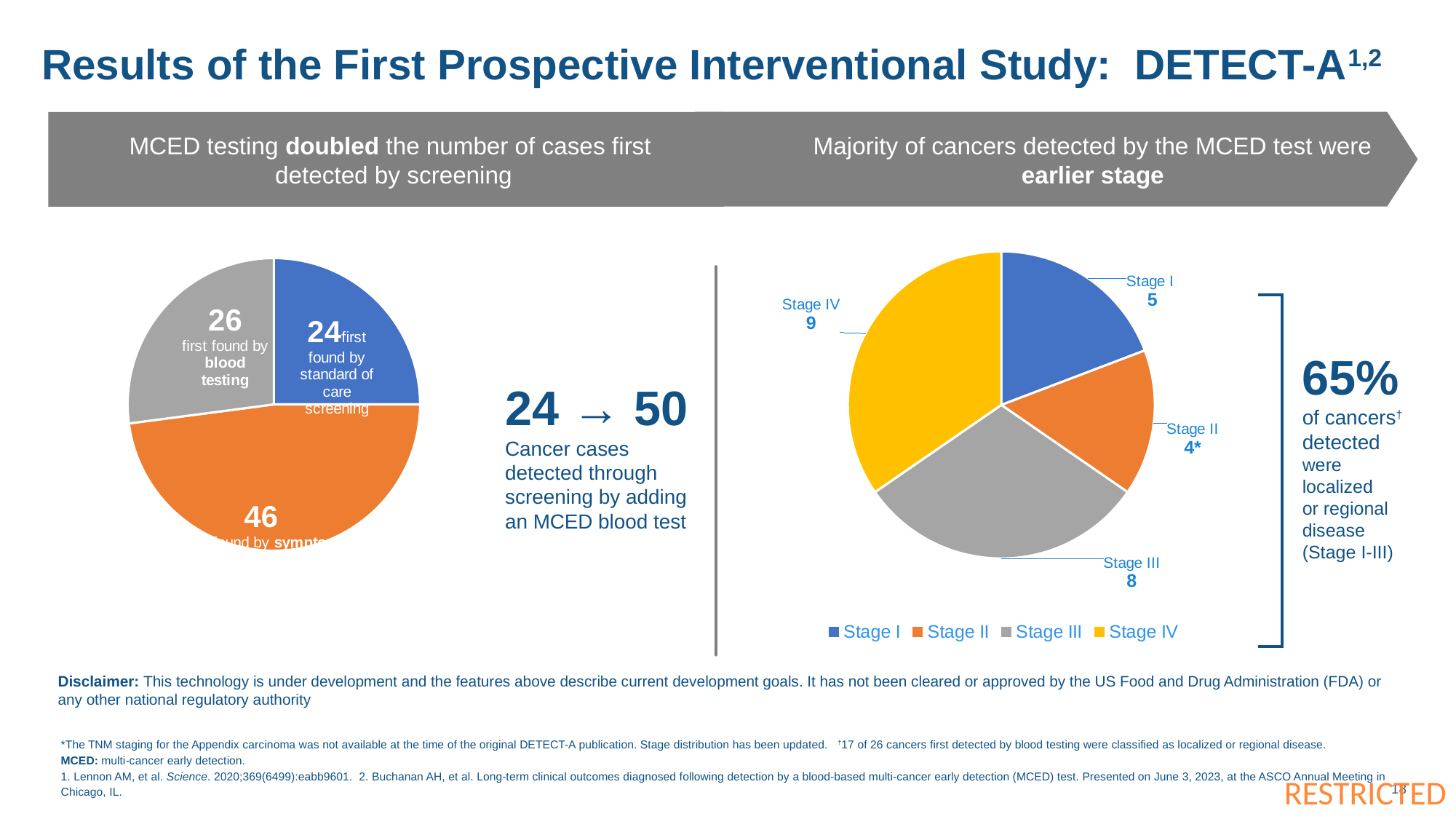
In the right pie chart, how many cancers were Stage IV? 9 In the right pie chart, which stage has the smallest slice? Stage II In the right pie chart, which is larger, Stage I or Stage IV? Stage IV How many series does the legend of the right pie chart list? 4 In the left pie chart, which category has the largest slice? found by symptoms In the left pie chart, how many cancer cases were found by symptoms? 46 In the left pie chart, how many cancer cases were first found by blood testing? 26 In the left pie chart, how many cases were first found by standard of care screening? 24 In the left pie chart, what is the difference between cases found by symptoms and cases first found by blood testing? 20 In the right pie chart, how many cancers were Stage III? 8 In the left pie chart, what is the total number of cases across all three slices? 96 What type of chart is used on the right side of the slide? Pie chart